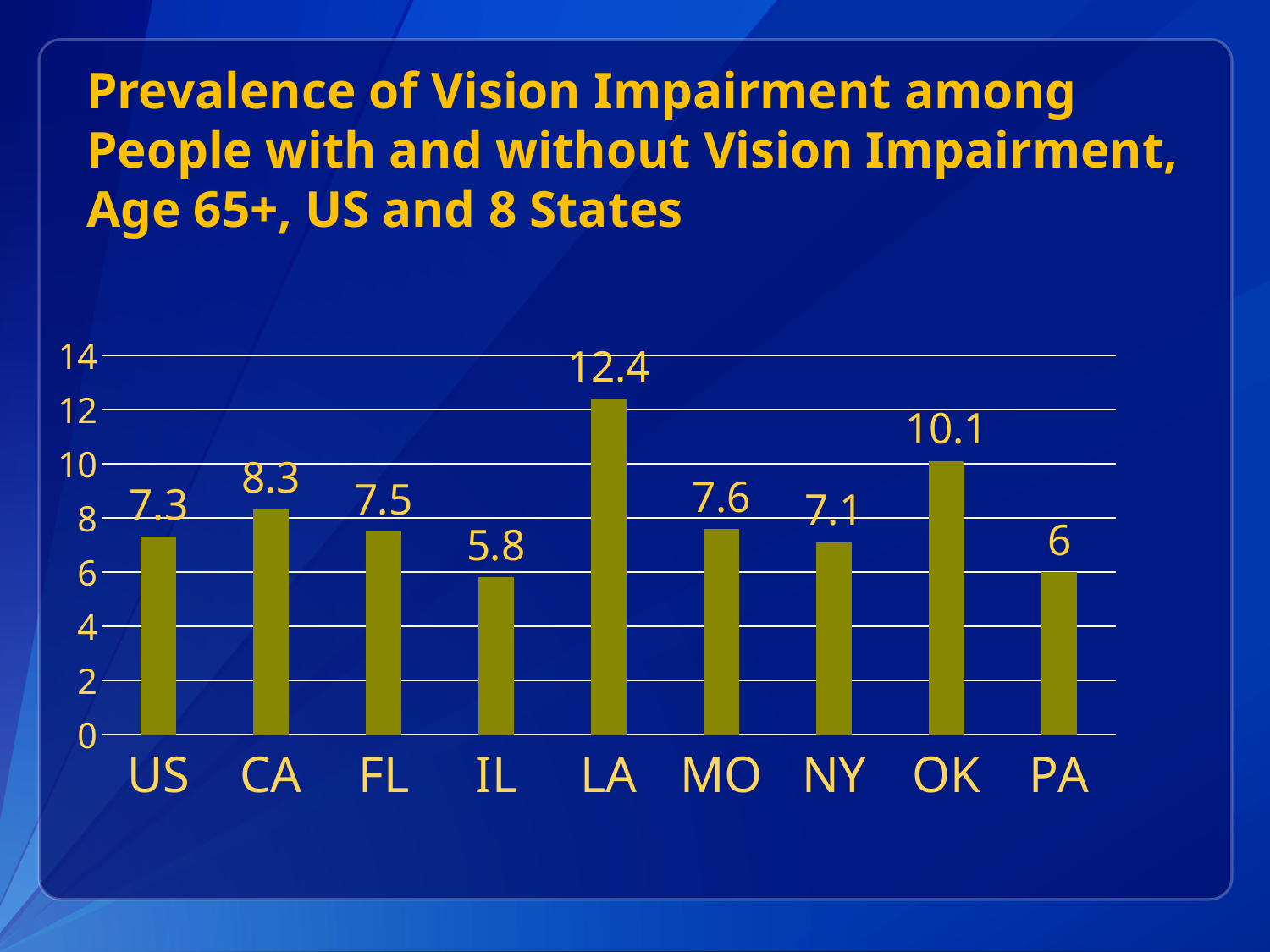
What is the value for IL? 5.8 What is the value for US? 7.3 What is the value for LA? 12.4 How many categories are shown on the x axis? 9 What is the difference between the values for LA and OK? 2.3 Is the value for LA greater or less than 12? greater Which category has the lowest value? IL Which is larger, the value for OK or the value for CA? OK What is the value for PA? 6 Which category has the highest value? LA What is the difference between the values for CA and US? 1 What kind of chart is shown on the slide? bar chart